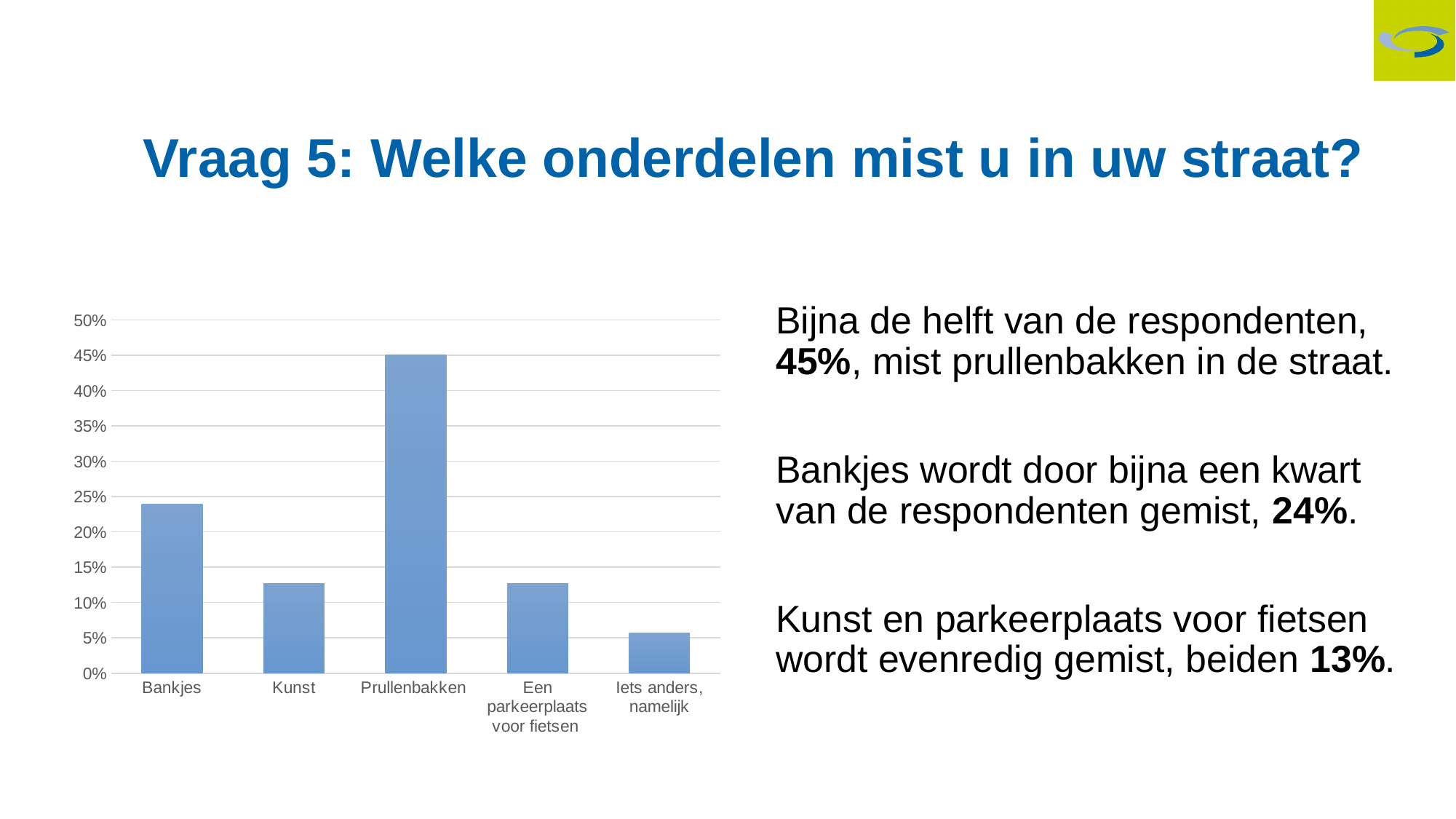
What is the difference between the values for Prullenbakken and Bankjes? 21% Which is larger, the value for Bankjes or the value for Kunst? Bankjes What percentage of respondents miss Bankjes, according to the slide? 24% What percentage of respondents miss Prullenbakken, according to the slide? 45% Which category has the lowest bar in the chart? Iets anders, namelijk What percentage of respondents miss Kunst, according to the slide? 13% How many categories are shown on the x axis of the chart? 5 What kind of chart is shown on the slide? bar chart What is the title of the slide containing the chart? Vraag 5: Welke onderdelen mist u in uw straat? Which category has the highest bar in the chart? Prullenbakken Is the value for Prullenbakken greater or less than 40%? greater Is the value for Iets anders, namelijk greater or less than 10%? less